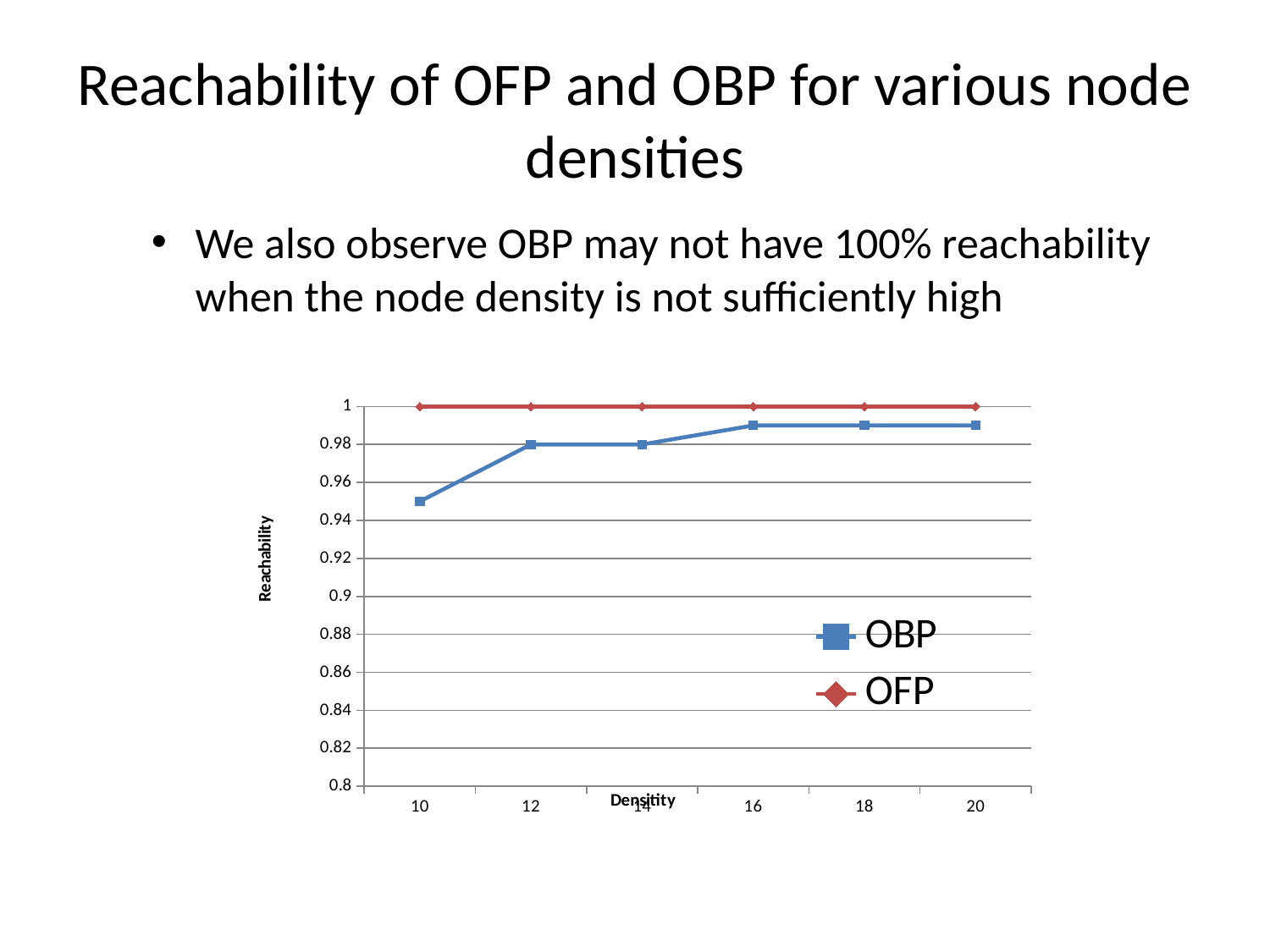
Is the reachability of OBP at density 16 greater or less than 0.98? greater What is the reachability of OBP at density 14? 0.98 What is the reachability of OBP at density 12? 0.98 Which two series are listed in the legend? OBP and OFP What kind of chart is shown on the slide? line chart What is the reachability of OFP at density 10? 1 Does the reachability of OBP rise or fall as density increases from 10 to 20? rise At which density is the reachability of OBP lowest? 10 How many series does the legend list? 2 How many density values are plotted along the x axis? 6 What is the reachability of OFP at density 20? 1 Is the reachability of OBP at density 10 greater or less than 0.96? less